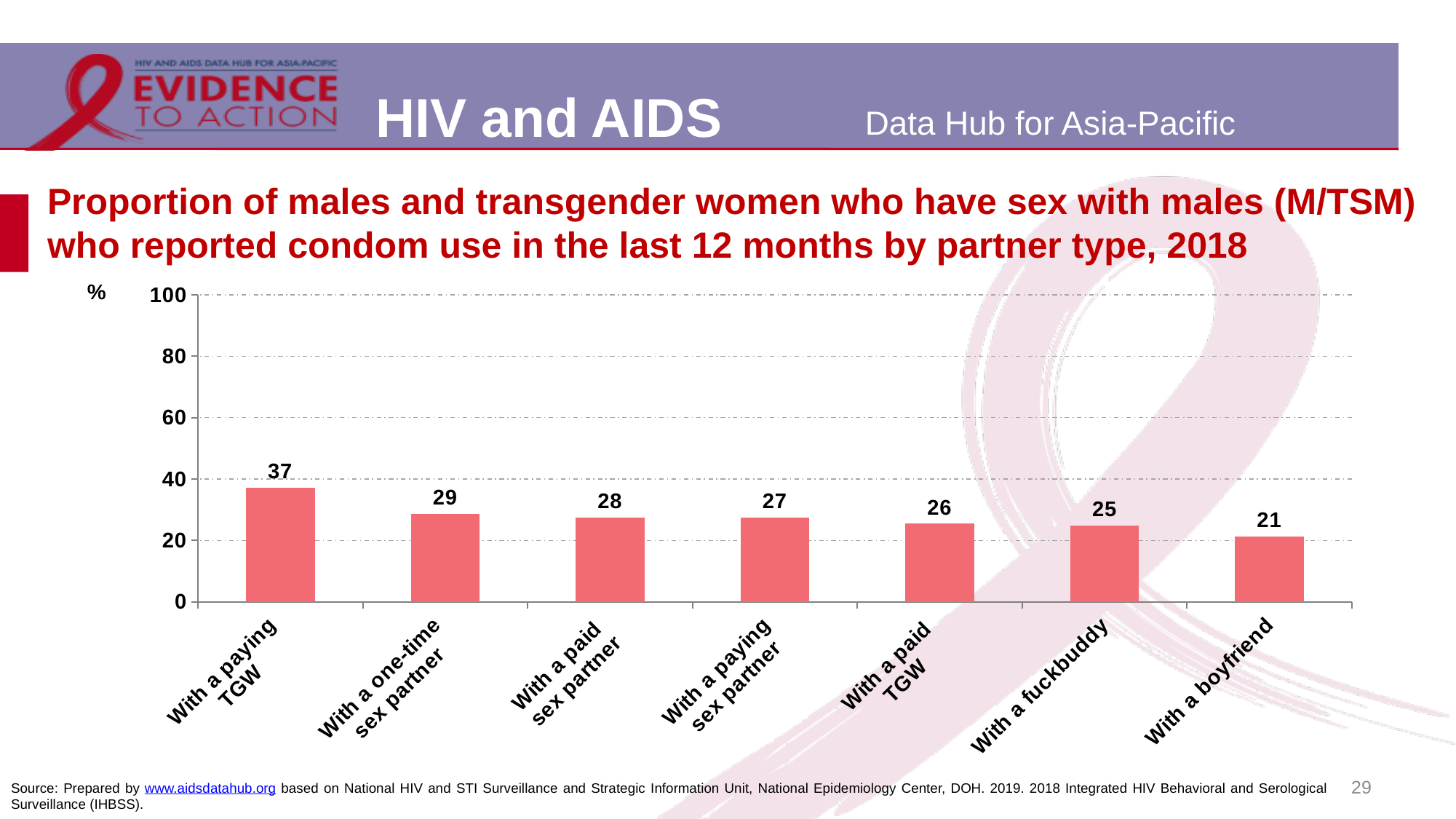
Is the value for 'With a paying sex partner' greater or less than 40? less What unit is shown on the y axis of the chart? % What is the value for 'With a paying TGW'? 37 What is the difference between the values for 'With a paying TGW' and 'With a boyfriend'? 16 Which is larger, the value for 'With a one-time sex partner' or 'With a paid TGW'? With a one-time sex partner What is the value for 'With a boyfriend'? 21 Which partner type has the highest reported condom use? With a paying TGW Do the values rise or fall from left to right across the partner types? Fall Which partner type has the lowest reported condom use? With a boyfriend What is the value for 'With a fuckbuddy'? 25 What kind of chart is shown on the slide? Bar chart How many partner types are shown on the chart? 7